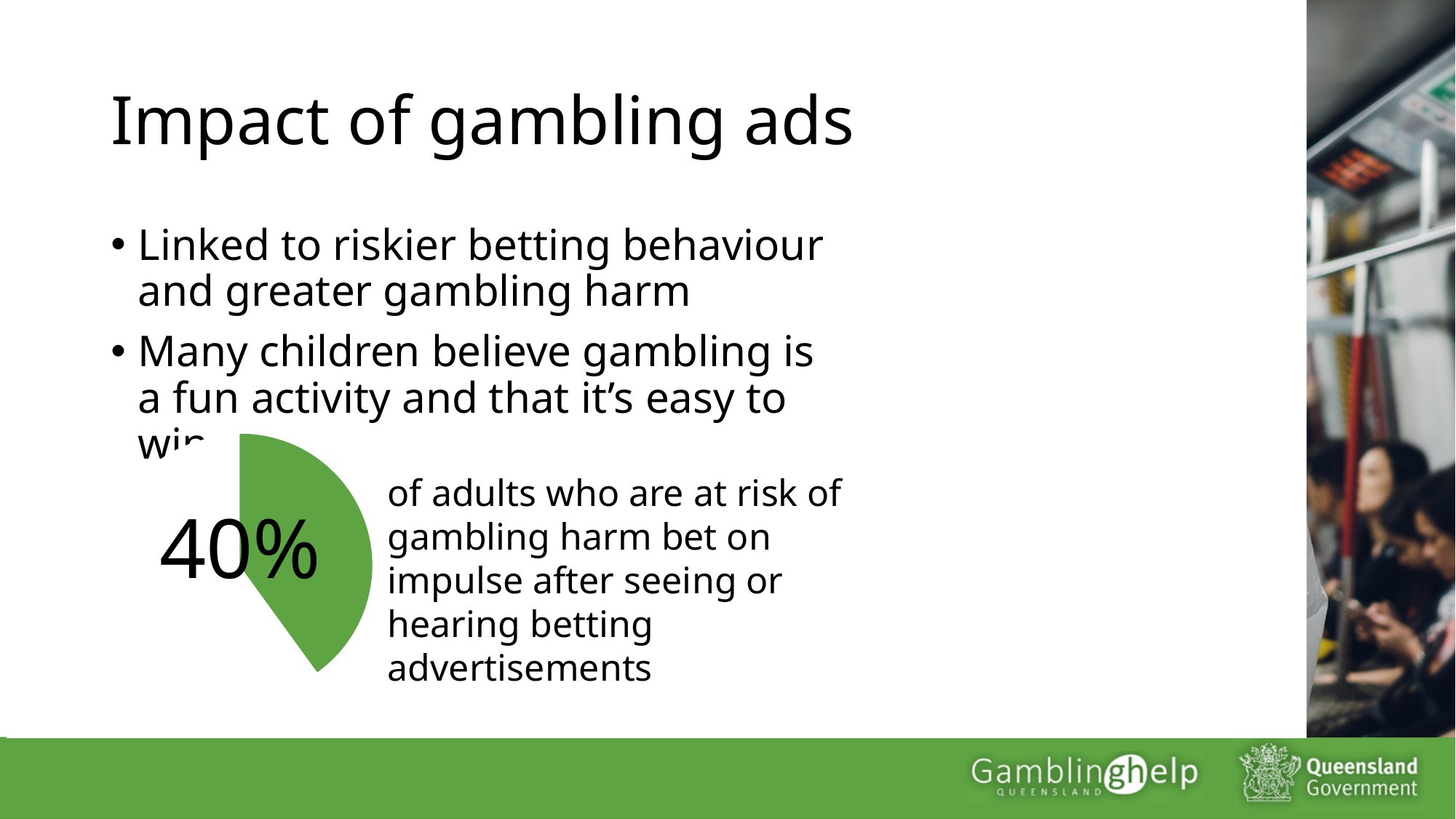
Is the share shown by the green slice of the pie chart greater or less than half of the pie? less According to the pie chart, what percentage of adults who are at risk of gambling harm bet on impulse after seeing or hearing betting advertisements? 40% What percentage is printed on the pie chart on the slide? 40% What kind of chart is shown on the slide next to the text about adults at risk of gambling harm? pie chart What colour is the highlighted slice of the pie chart? green What share of the pie does the green slice represent? 40%